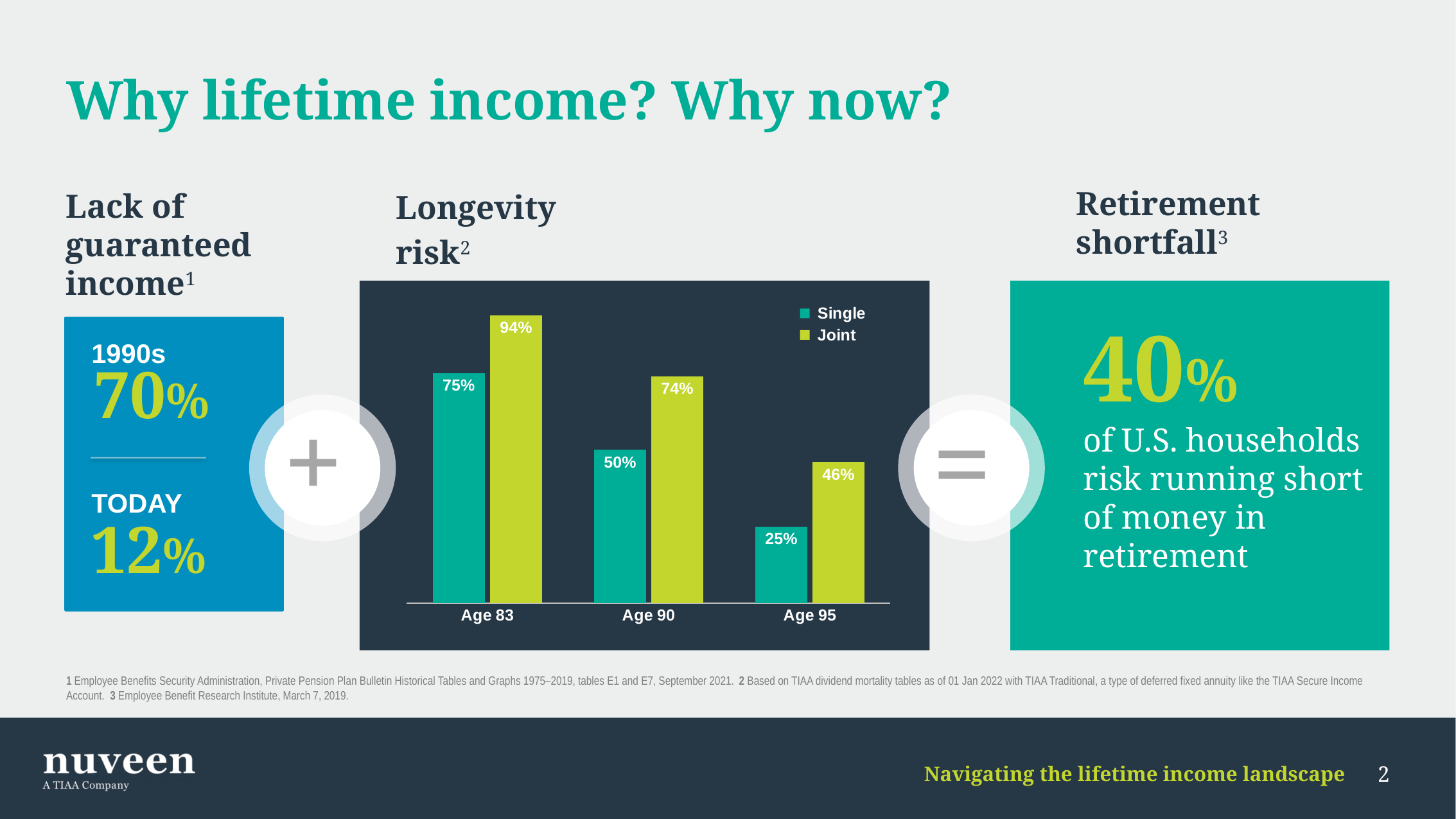
Do the Single values rise or fall as age increases along the x axis? Fall How many series does the legend list? 2 What is the value for Single at Age 95? 25% What is the difference between the Joint and Single values at Age 83? 19% How many age categories are shown on the x axis? 3 What is the value for Joint at Age 95? 46% Which is larger at Age 90: the Single value or the Joint value? Joint What is the value for Joint at Age 90? 74% What is the value for Single at Age 83? 75% Which age category has the highest Joint value? Age 83 What kind of chart is shown under Longevity risk? Bar chart Which age category has the lowest Single value? Age 95